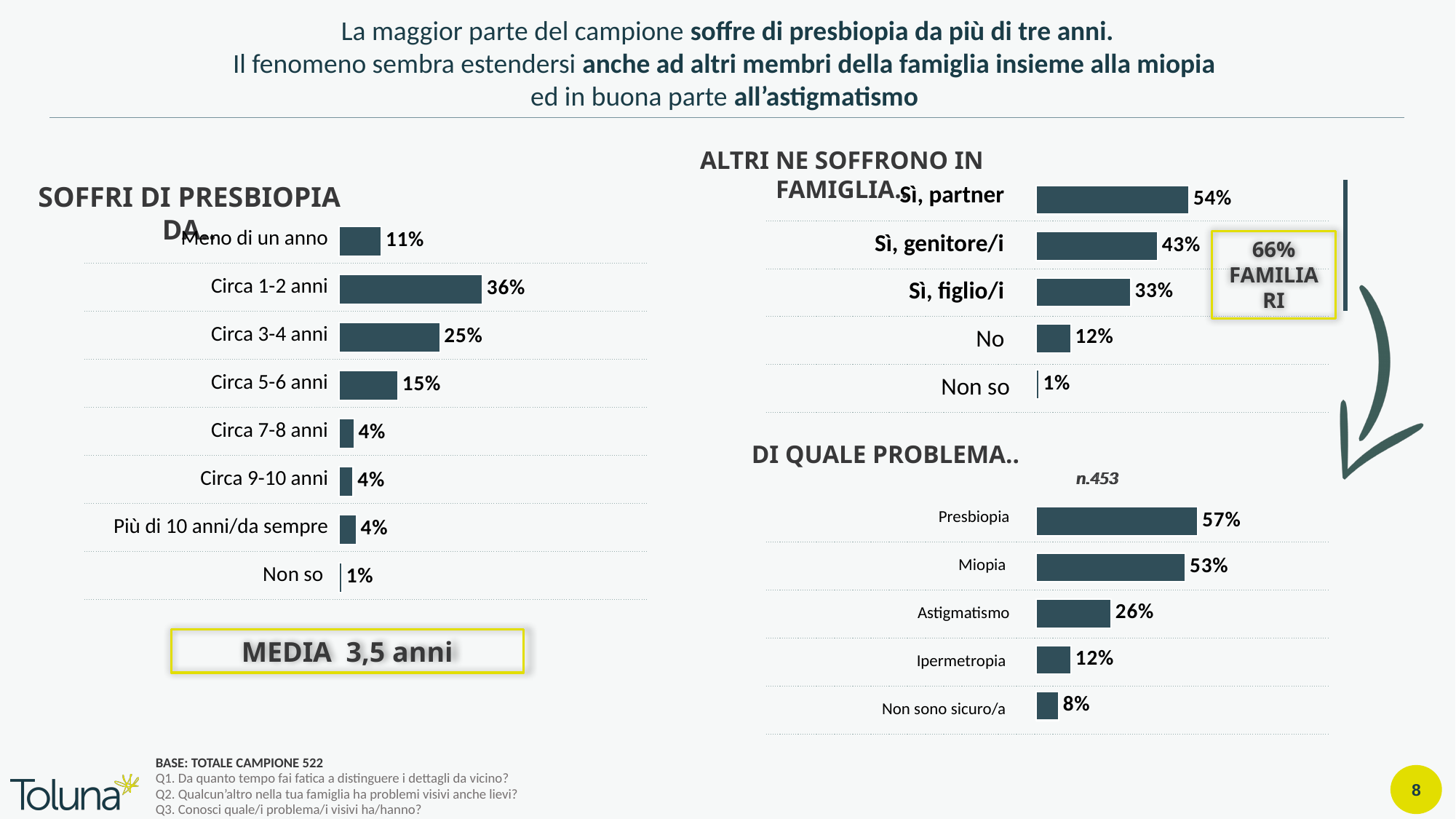
In the 'DI QUALE PROBLEMA..' chart, what is the difference between 'Presbiopia' and 'Miopia'? 4% In the 'ALTRI NE SOFFRONO IN FAMIGLIA..' chart, which is larger: 'Sì, partner' or 'Sì, figlio/i'? Sì, partner In the 'ALTRI NE SOFFRONO IN FAMIGLIA..' chart, what is the value for 'Sì, genitore/i'? 43% In the 'SOFFRI DI PRESBIOPIA DA..' chart, what is the value for 'Meno di un anno'? 11% In the 'SOFFRI DI PRESBIOPIA DA..' chart, what is the difference between 'Circa 3-4 anni' and 'Circa 5-6 anni'? 10% In the 'ALTRI NE SOFFRONO IN FAMIGLIA..' chart, which category has the lowest value? Non so In the 'DI QUALE PROBLEMA..' chart, what is the value for 'Astigmatismo'? 26% In the 'SOFFRI DI PRESBIOPIA DA..' chart, which category has the highest value? Circa 1-2 anni In the 'DI QUALE PROBLEMA..' chart, which category has the highest value? Presbiopia In the 'SOFFRI DI PRESBIOPIA DA..' chart, how many categories are shown? 8 What type of chart is the 'DI QUALE PROBLEMA..' chart? Bar chart In the 'SOFFRI DI PRESBIOPIA DA..' chart, what is the value for 'Circa 1-2 anni'? 36%